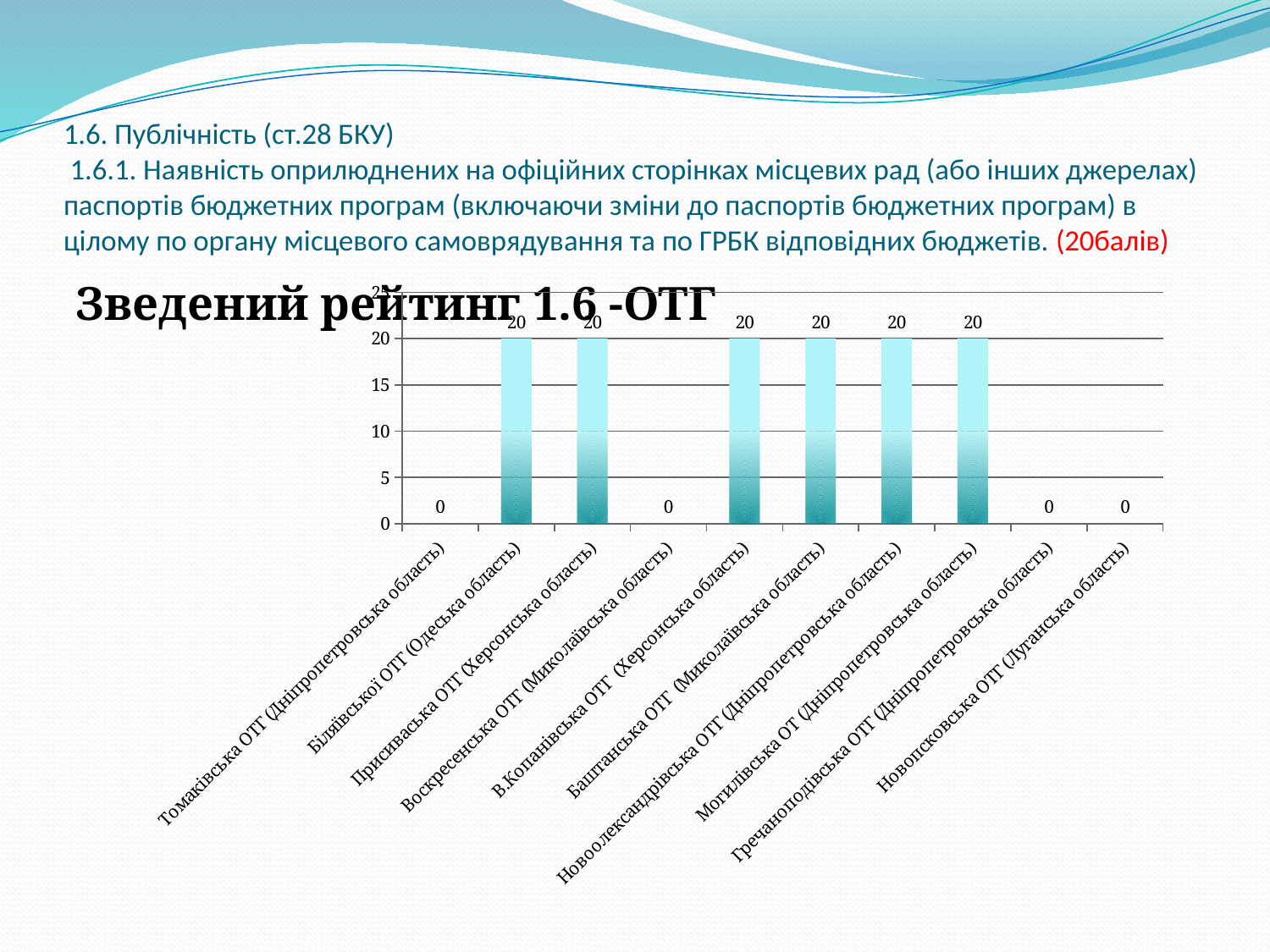
How many categories are shown on the x axis of the chart? 10 What is the title of the chart? Зведений рейтинг 1.6 -ОТГ What value is shown for Біляївської ОТГ (Одеська область)? 20 What value is shown for Баштанська ОТГ (Миколаївська область)? 20 How many categories have a value of 20? 6 What value is shown for Новопсковська ОТГ (Луганська область)? 0 What is the difference between the values for Присиваська ОТГ (Херсонська область) and Гречанополівська ОТГ (Дніпропетровська область)? 20 What is the highest value shown on the y axis of the chart? 25 What value is shown for Воскресенська ОТГ (Миколаївська область)? 0 What kind of chart is shown on the slide? bar chart What value is shown for Томаківська ОТГ (Дніпропетровська область)? 0 Which is larger, the value for Могилівська ОТ (Дніпропетровська область) or the value for Томаківська ОТГ (Дніпропетровська область)? Могилівська ОТ (Дніпропетровська область)